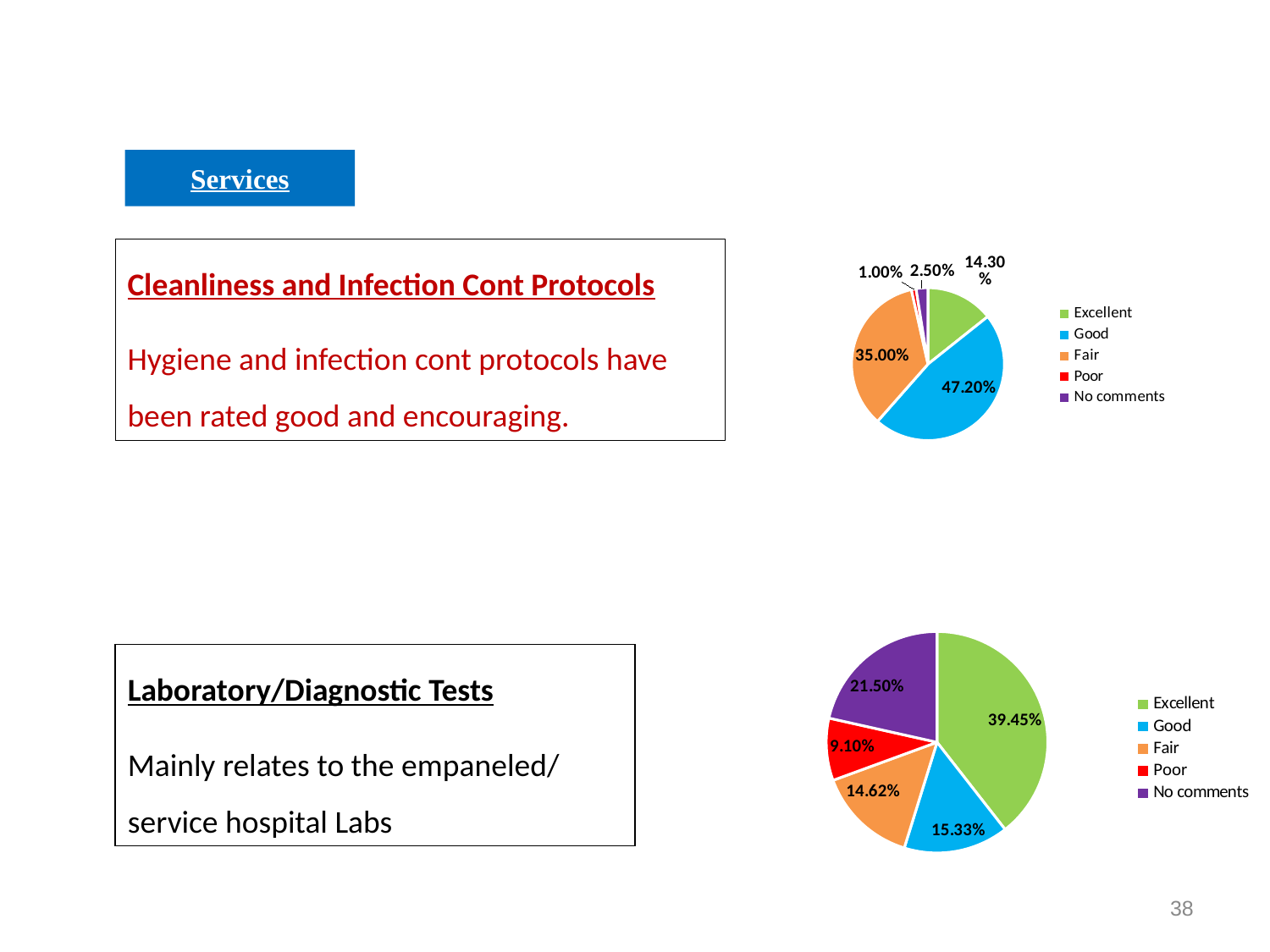
In the top pie chart (next to 'Cleanliness and Infection Cont Protocols'), how many categories does the legend list? 5 In the top pie chart (next to 'Cleanliness and Infection Cont Protocols'), which category has the largest slice? Good In the bottom pie chart (next to 'Laboratory/Diagnostic Tests'), what share is labelled for the Excellent slice? 39.45% What type of chart is used for the 'Laboratory/Diagnostic Tests' data at the bottom of the slide? Pie chart In the bottom pie chart (next to 'Laboratory/Diagnostic Tests'), what is the difference between the Excellent and No comments shares? 17.95% In the top pie chart (next to 'Cleanliness and Infection Cont Protocols'), what share is labelled for the Fair slice? 35.00% In the bottom pie chart (next to 'Laboratory/Diagnostic Tests'), which category has the smallest slice? Poor In the bottom pie chart (next to 'Laboratory/Diagnostic Tests'), what share is labelled for the No comments slice? 21.50% In the top pie chart (next to 'Cleanliness and Infection Cont Protocols'), what share is labelled for the Good slice? 47.20% In the top pie chart (next to 'Cleanliness and Infection Cont Protocols'), what is the difference between the Good and Fair shares? 12.20% In the bottom pie chart (next to 'Laboratory/Diagnostic Tests'), which is larger, the Good slice or the Fair slice? Good In the top pie chart (next to 'Cleanliness and Infection Cont Protocols'), which category has the smallest slice? Poor